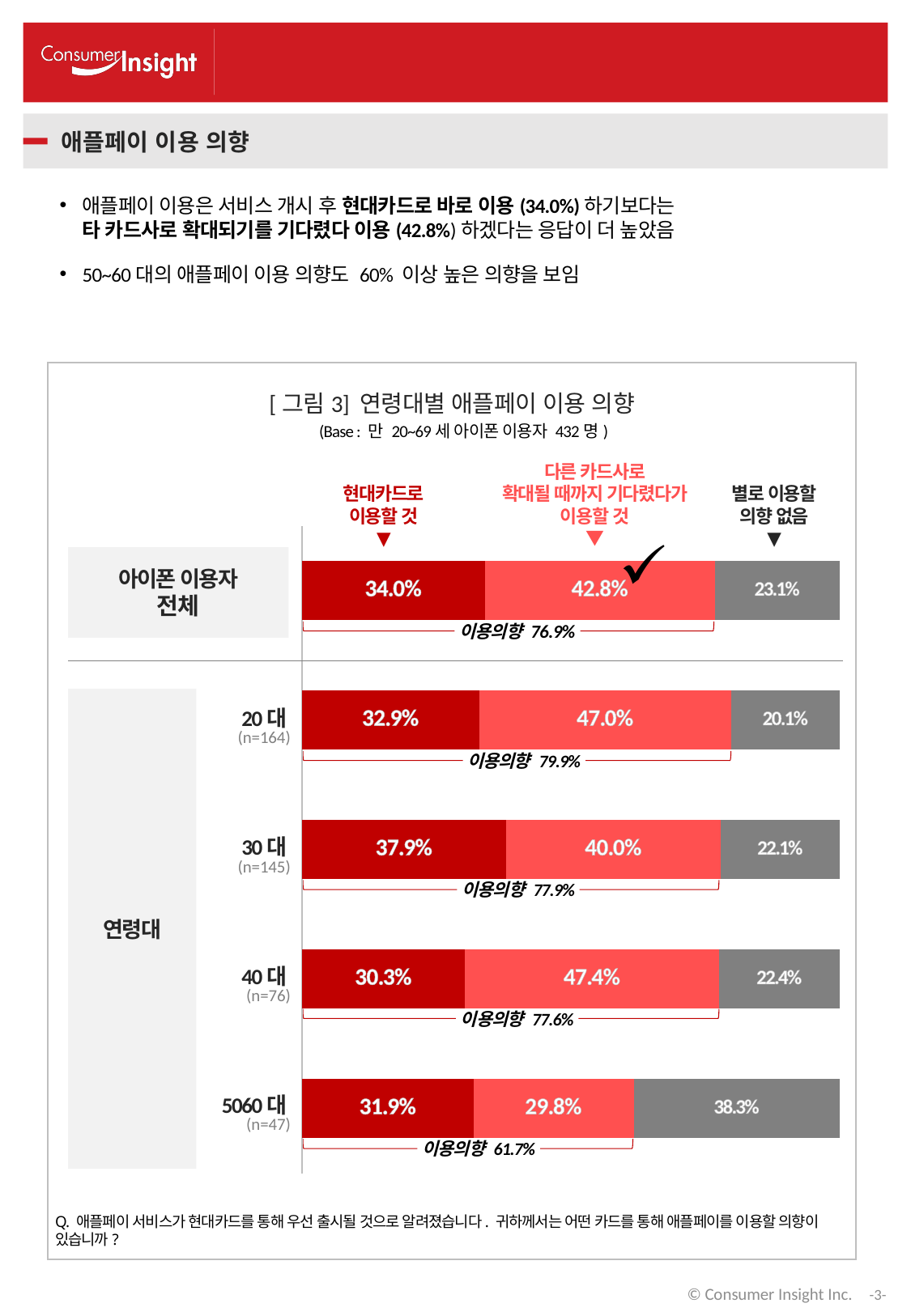
What is the difference between the 다른 카드사로 확대될 때까지 기다렸다가 이용할 것 value and the 현대카드로 이용할 것 value for 아이폰 이용자 전체? 8.8% What kind of chart is shown in [그림 3] 연령대별 애플페이 이용 의향? Stacked bar chart How many age groups (excluding 아이폰 이용자 전체) are shown in the chart? 4 How many response categories (series) are shown in each bar? 3 Which age group has the lowest value for 현대카드로 이용할 것? 40대 What is the combined 이용의향 (현대카드로 이용할 것 plus 다른 카드사로 확대될 때까지 기다렸다가 이용할 것) for the 40대 group? 77.6% What is the value for 별로 이용할 의향 없음 in the 5060대 group? 38.3% What is the value for 다른 카드사로 확대될 때까지 기다렸다가 이용할 것 in the 20대 group? 47.0% What is the sample size (n) for the 30대 group? 145 Which age group has the highest value for 별로 이용할 의향 없음? 5060대 What is the value for 현대카드로 이용할 것 among 아이폰 이용자 전체? 34.0% Which is larger in the 30대 group: 현대카드로 이용할 것 or 별로 이용할 의향 없음? 현대카드로 이용할 것